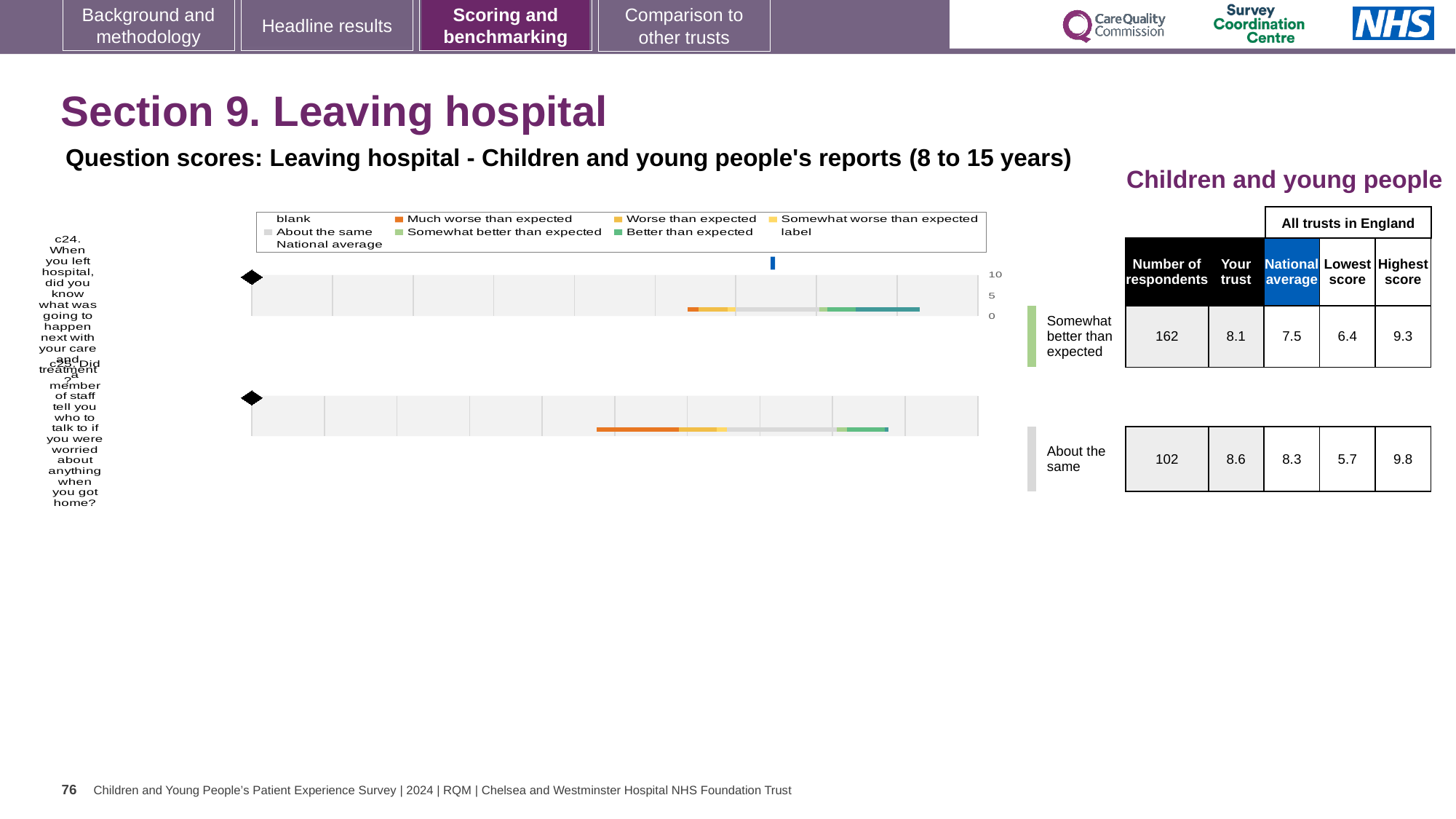
What kind of chart is used to show the question scores for Leaving hospital? bar chart Which question has the higher 'Your trust' score, c24 or c25? c25 How many entries does the legend of the Leaving hospital chart list? 9 What is the 'Your trust' score for question c24 (did you know what was going to happen next with your care and treatment)? 8.1 How many questions (bars) are plotted in the Leaving hospital chart? 2 How many respondents answered question c24? 162 By how much does the trust's score for c24 exceed the national average for c24? 0.6 Which benchmarking category is question c24 placed in? Somewhat better than expected What is the difference between the highest and lowest scores in England for question c25? 4.1 Which benchmarking category is question c25 placed in? About the same What is the highest score across all trusts in England for question c25? 9.8 What is the national average score for question c25 (did a member of staff tell you who to talk to if you were worried when you got home)? 8.3